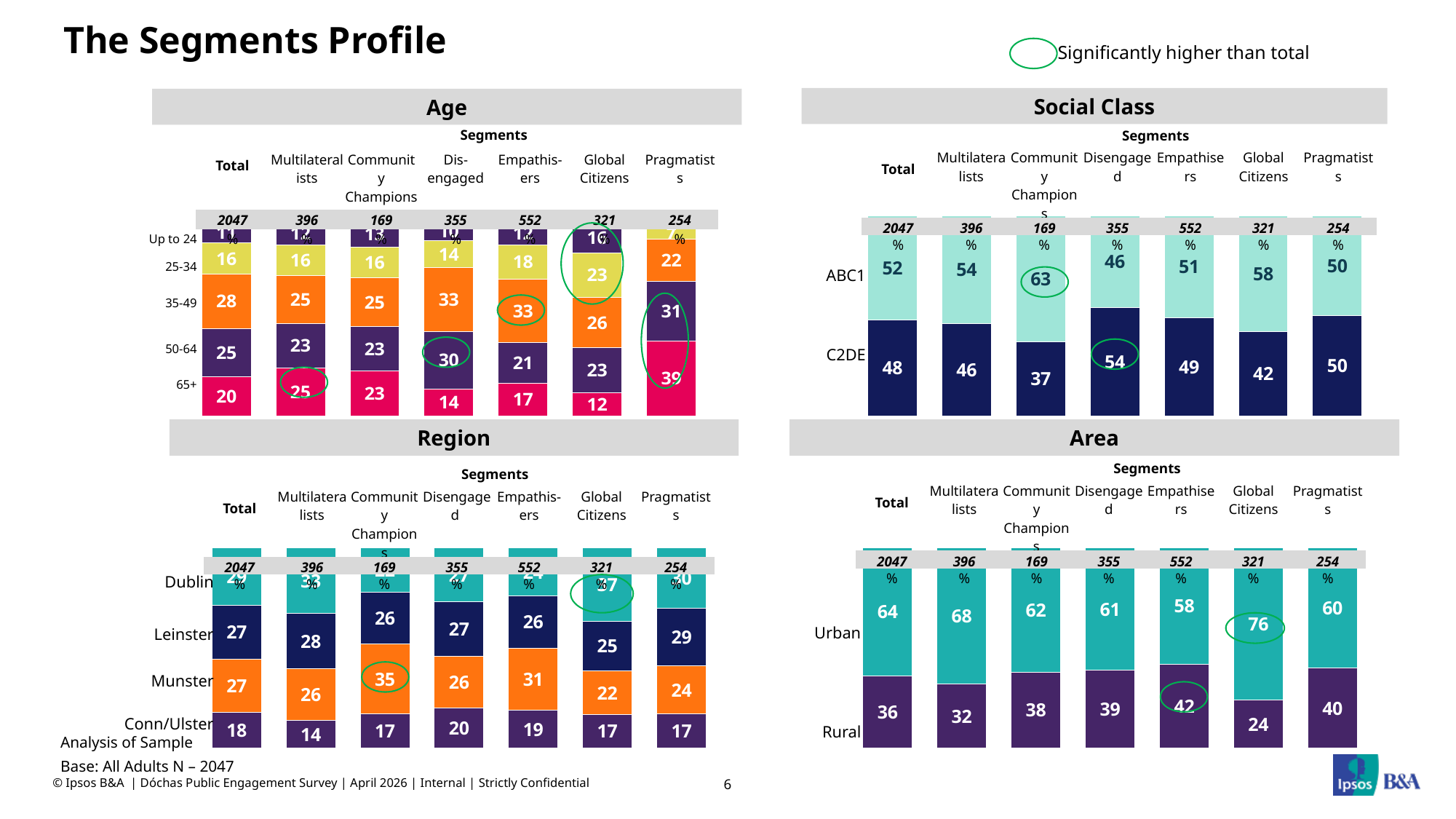
In the Age chart, what is the difference between the 50-64 value for Disengaged and the 50-64 value for Total? 5 In the Area chart, what is the difference between the Urban value for Global Citizens and the Urban value for Total? 12 In the Region chart, which is larger: the Conn/Ulster value for Disengaged or for Multilateralists? Disengaged In the Age chart, which segment has the lowest 65+ value? Global Citizens How many segment columns (including Total) are shown in the Social Class chart? 7 In the Area chart, which segment has the highest Urban value? Global Citizens In the Age chart, what is the 65+ value for Pragmatists? 39 In the Social Class chart, what is the C2DE value for Disengaged? 54 In the Region chart, what is the Munster value for Community Champions? 35 In the Social Class chart, what is the ABC1 value for Community Champions? 63 In the Area chart, which segment has the lowest Rural value? Global Citizens What type of chart is the Area chart? Stacked bar chart